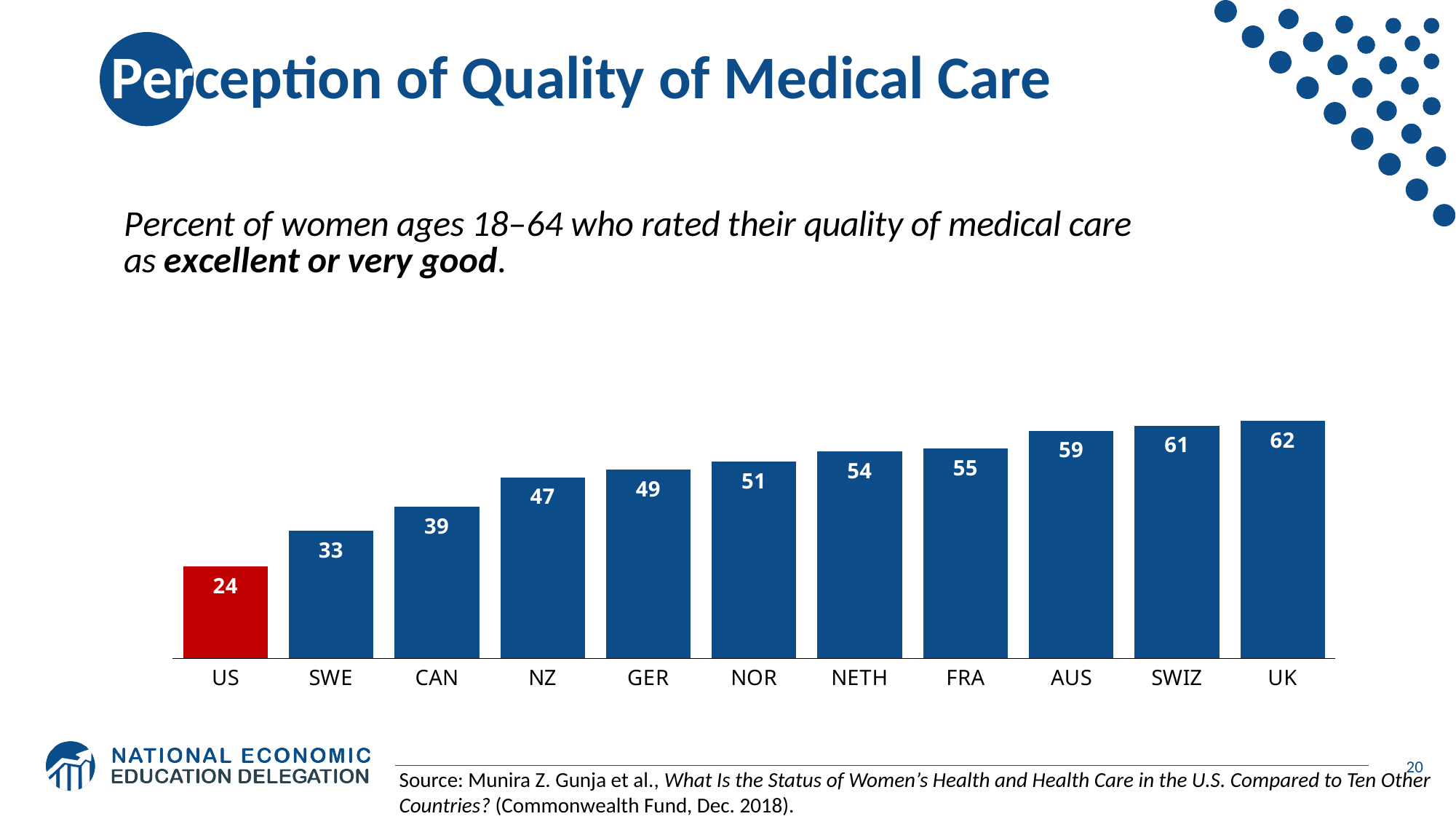
Which country has the highest value? UK What is the difference between the values for UK and US? 38 Which country has the lowest value? US What is the value for the US? 24 What is the value for GER? 49 How many countries are shown in the chart? 11 What is the difference between the values for CAN and SWE? 6 What is the value for AUS? 59 What kind of chart is shown on the slide? bar chart Which bar is coloured red rather than blue? US Do the values rise or fall from left to right along the x axis? rise Which is larger, the value for NOR or the value for NZ? NOR